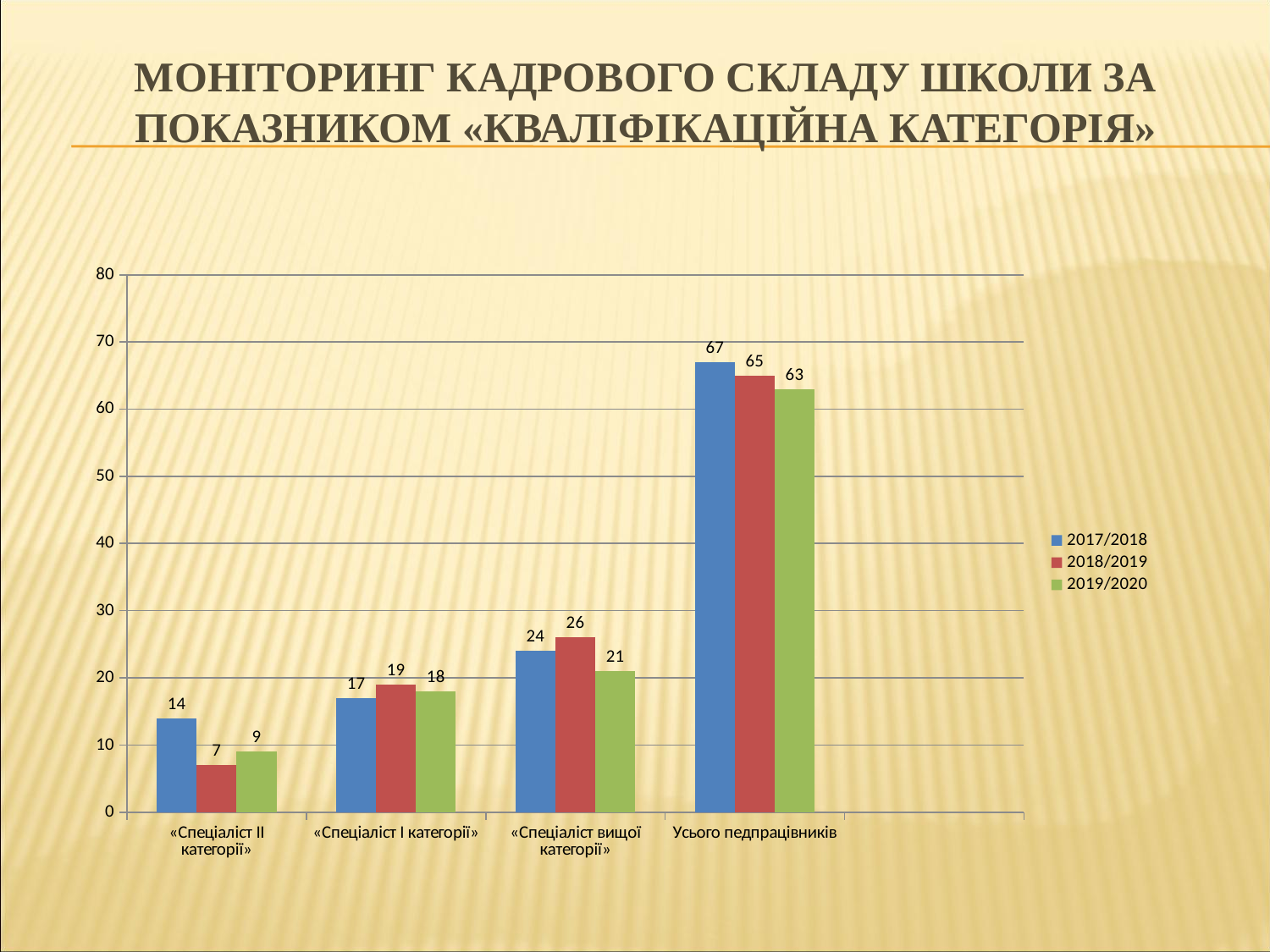
How many series does the legend list? 3 What is the difference between the 2017/2018 and 2019/2020 values for Усього педпрацівників? 4 What is the value for «Спеціаліст вищої категорії» in the 2018/2019 series? 26 Which is larger for «Спеціаліст I категорії»: the 2018/2019 value or the 2017/2018 value? 2018/2019 What is the value for Усього педпрацівників in the 2019/2020 series? 63 Which category has the highest value in the 2017/2018 series? Усього педпрацівників Is the value for «Спеціаліст вищої категорії» in 2019/2020 greater or less than 30? less How many categories are shown on the x axis? 4 Which colour represents the 2019/2020 series in the legend? green What kind of chart is shown on the slide? bar chart Which category has the lowest value in the 2018/2019 series? «Спеціаліст II категорії» What is the value for «Спеціаліст II категорії» in the 2017/2018 series? 14